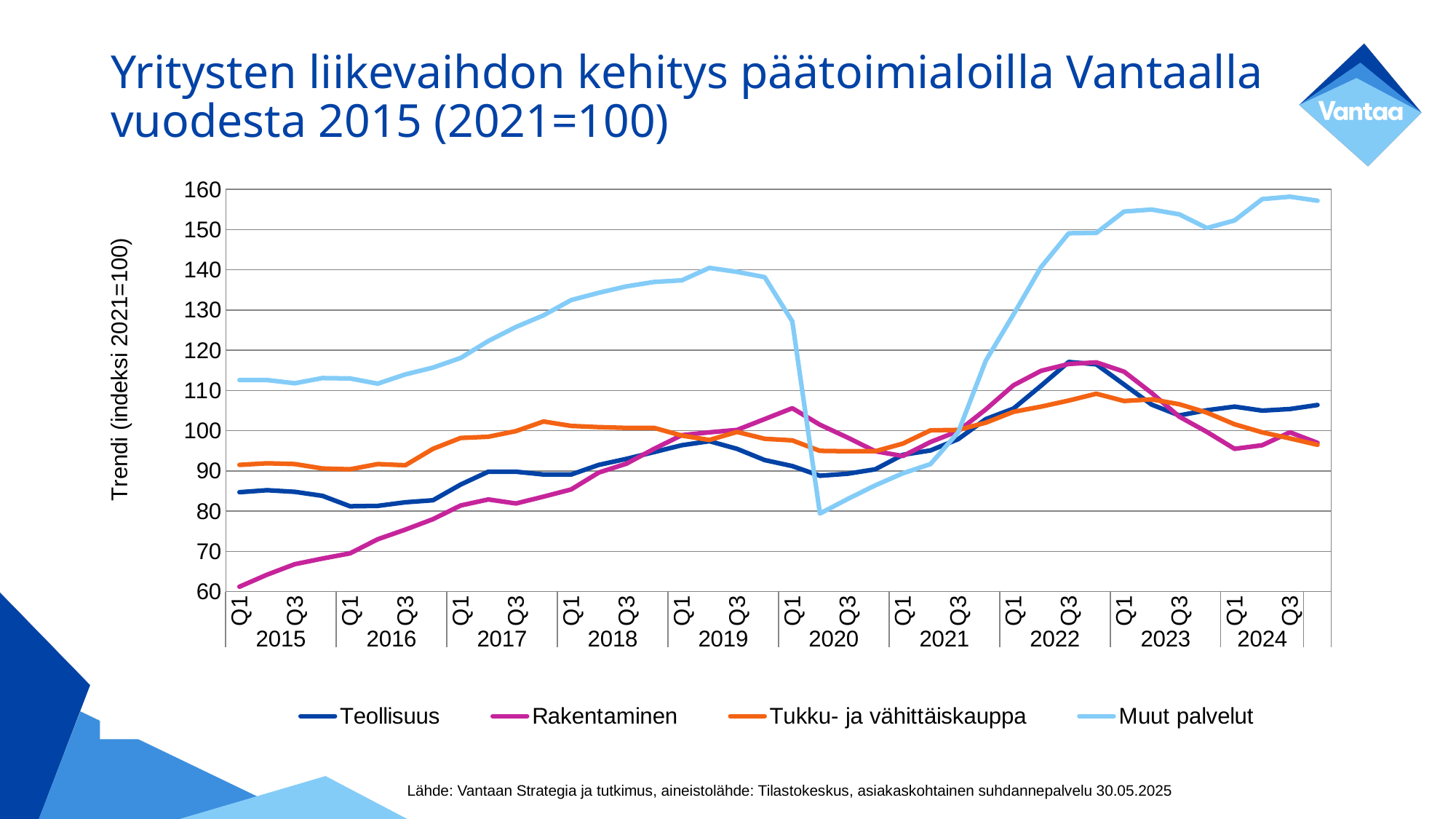
How many years are labelled along the x axis? 10 Is the value for Rakentaminen at Q1 2015 greater or less than 70? less What kind of chart is shown on the slide? line chart Is the value for Muut palvelut at Q3 2024 greater or less than 150? greater How many series does the legend list? 4 At Q1 2015, which is higher: Teollisuus or Rakentaminen? Teollisuus Which series are listed in the legend? Teollisuus, Rakentaminen, Tukku- ja vähittäiskauppa, Muut palvelut Is the value for Teollisuus at Q1 2015 greater or less than 90? less Which series has the lowest value at Q1 2015? Rakentaminen Which series has the highest value at Q3 2024? Muut palvelut What is the label of the vertical axis? Trendi (indeksi 2021=100)